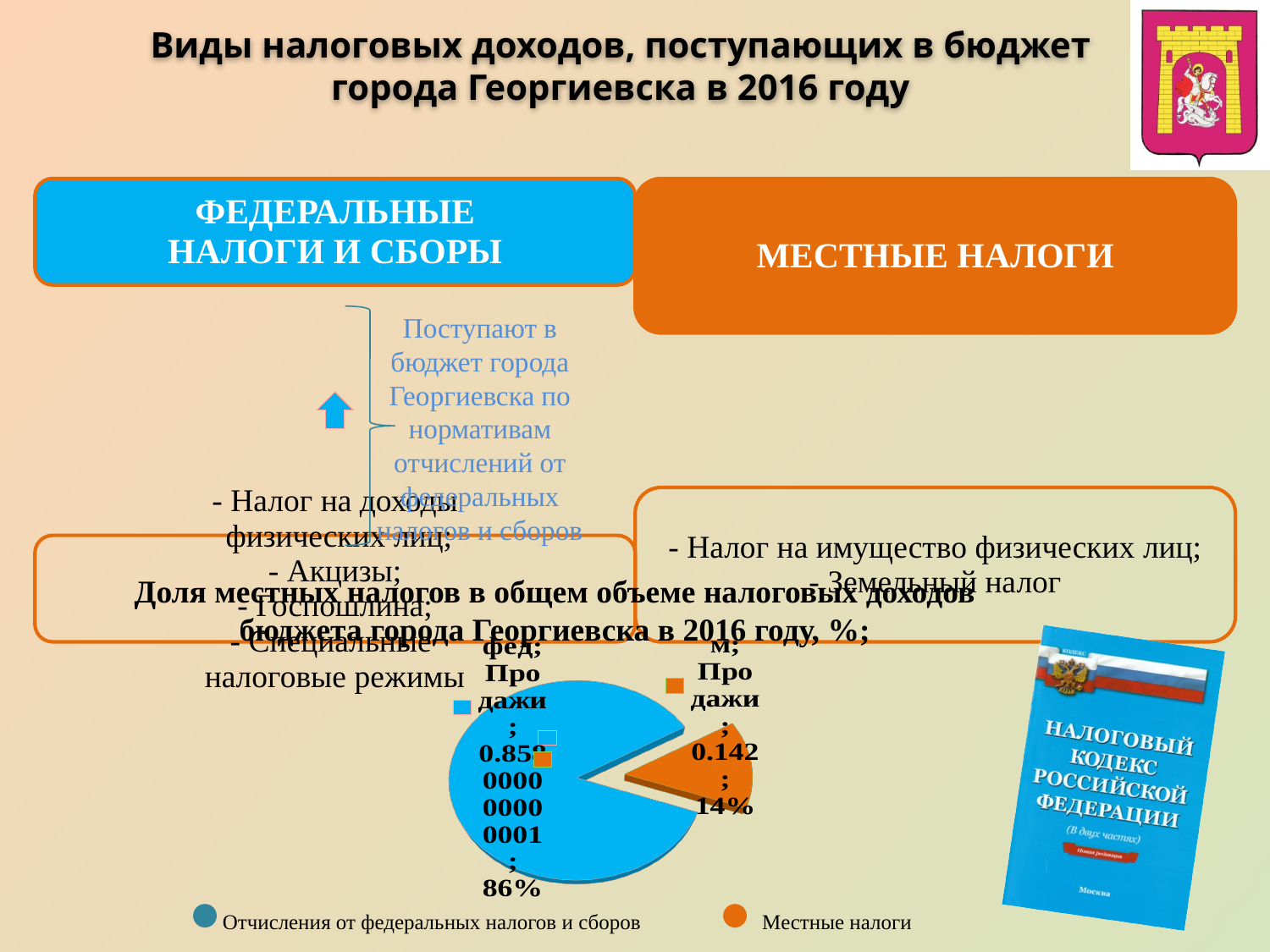
How many slices does the pie chart have? 2 Which slice of the pie chart is the smallest? Местные налоги What colour is the slice for 'Отчисления от федеральных налогов и сборов' in the pie chart? blue What percentage share does the slice for 'Отчисления от федеральных налогов и сборов' have in the pie chart? 86% By how many percentage points does the federal share exceed the local share in the pie chart? 72 What colour is the slice for 'Местные налоги' in the pie chart? orange Which is larger in the pie chart: the share of 'Местные налоги' or the share of 'Отчисления от федеральных налогов и сборов'? Отчисления от федеральных налогов и сборов What percentage share does the slice for 'Местные налоги' have in the pie chart? 14% How many entries does the legend of the pie chart list? 2 Which slice of the pie chart is the largest? Отчисления от федеральных налогов и сборов What kind of chart is shown on the slide? pie chart